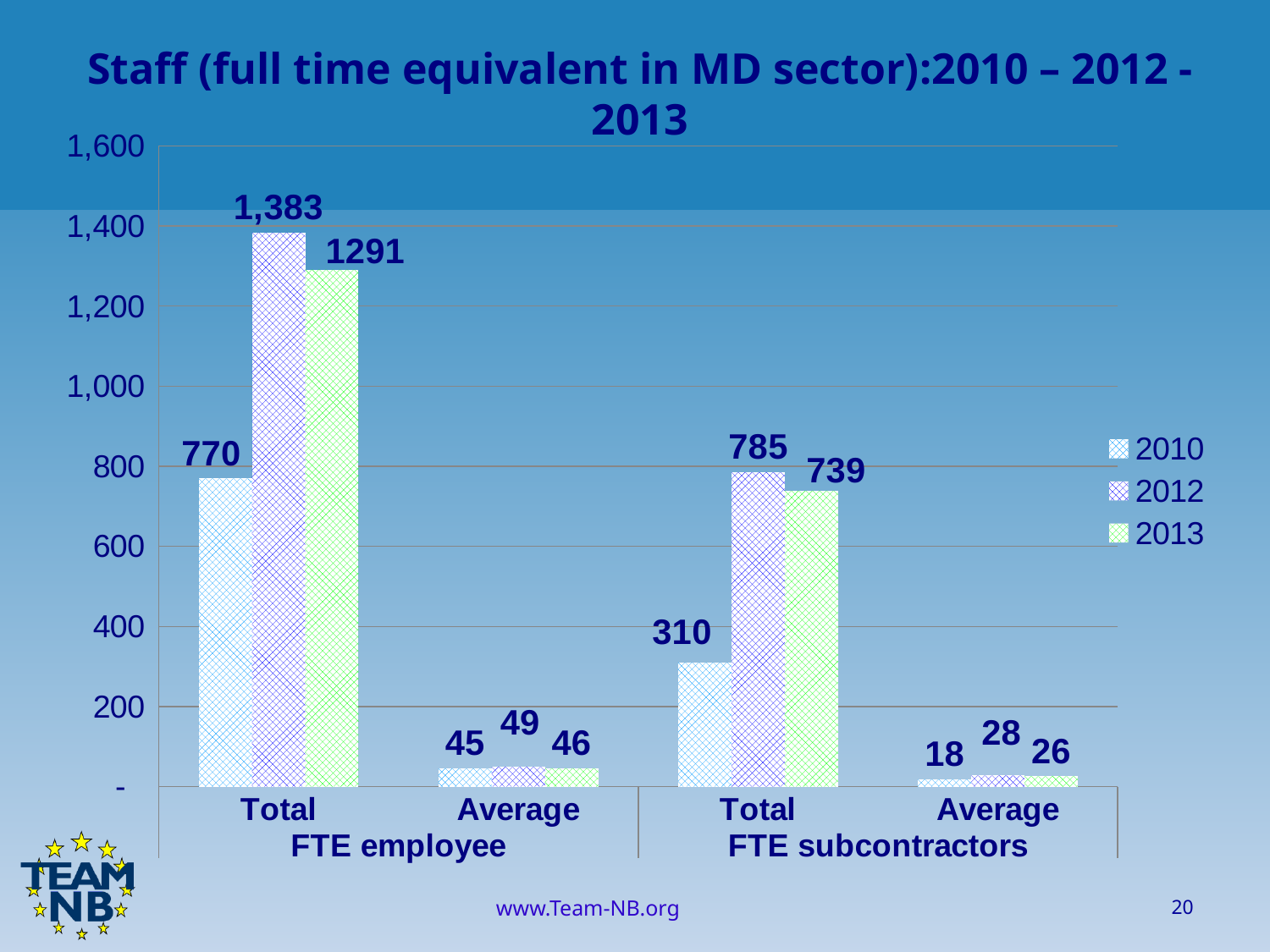
Which year has the highest value for Total FTE employee? 2012 What kind of chart is shown on the slide? Bar chart What is the value for Total FTE employee in 2012? 1,383 What is the difference between the 2010 and 2012 values for Total FTE employee? 613 What is the title of the chart? Staff (full time equivalent in MD sector):2010 – 2012 - 2013 Which year has the lowest value for Total FTE subcontractors? 2010 What is the value for Average FTE subcontractors in 2013? 26 What is the difference between the 2012 and 2013 values for Total FTE subcontractors? 46 What is the value for Total FTE subcontractors in 2010? 310 What is the value for Average FTE employee in 2012? 49 Which is larger: the 2013 value for Total FTE employee or the 2013 value for Total FTE subcontractors? Total FTE employee How many series does the legend list? 3